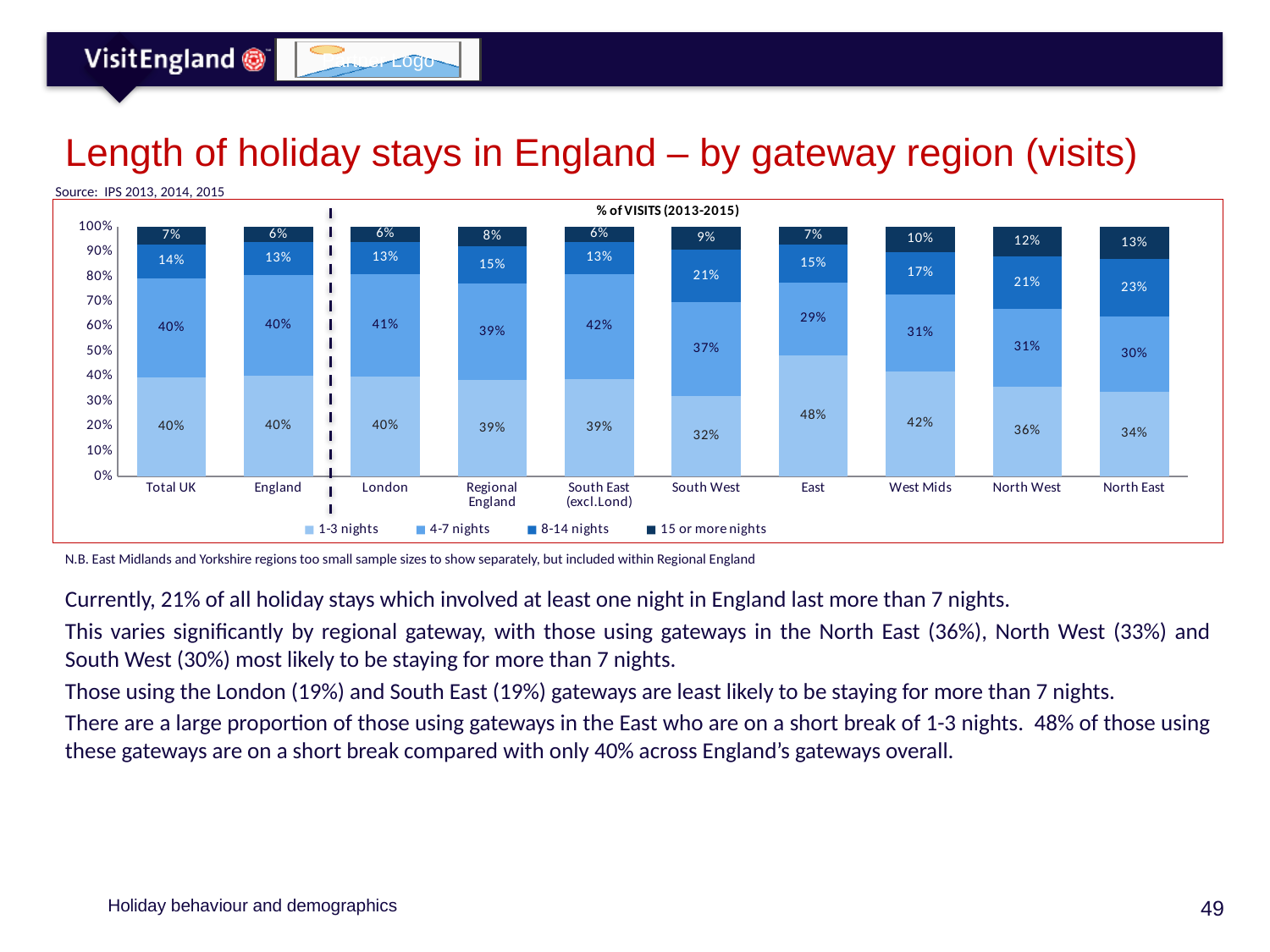
How many series does the legend list? 4 Which gateway region has the highest value for 15 or more nights? North East What is the value for 4-7 nights for London? 41% What is the value for 8-14 nights for South West? 21% How many gateway region categories are shown on the x axis? 10 What is the value for 1-3 nights for East? 48% What is the difference between the 1-3 nights value for East and the 1-3 nights value for England? 8% What is the value for 15 or more nights for North East? 13% Which gateway region has the highest value for 1-3 nights? East Which gateway region has the lowest value for 1-3 nights? South West What kind of chart is shown on the slide? Stacked bar chart Which is larger: the 8-14 nights value for North East or the 8-14 nights value for West Mids? North East